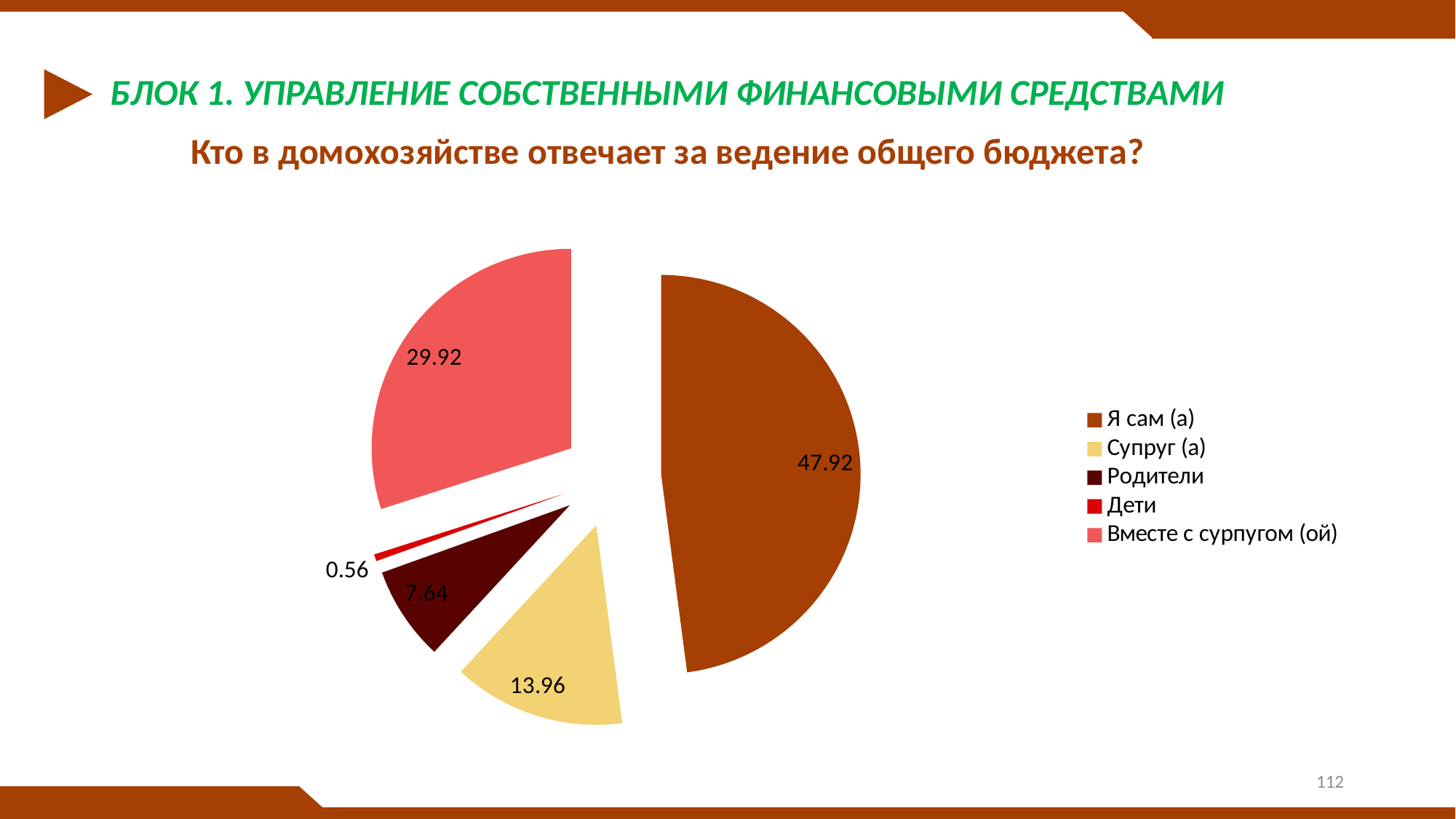
How many categories does the pie chart have? 5 Which category has the largest slice? Я сам (а) What is the value for "Родители"? 7.64 What is the difference between the values for "Я сам (а)" and "Вместе с сурпугом (ой)"? 18.00 Which is larger, the value for "Супруг (а)" or the value for "Родители"? Супруг (а) What is the value for "Вместе с сурпугом (ой)"? 29.92 What is the value for "Я сам (а)"? 47.92 What kind of chart is shown on the slide? pie chart What is the value for "Дети"? 0.56 What is the value for "Супруг (а)"? 13.96 Which category has the smallest slice? Дети What is the title of the chart? Кто в домохозяйстве отвечает за ведение общего бюджета?